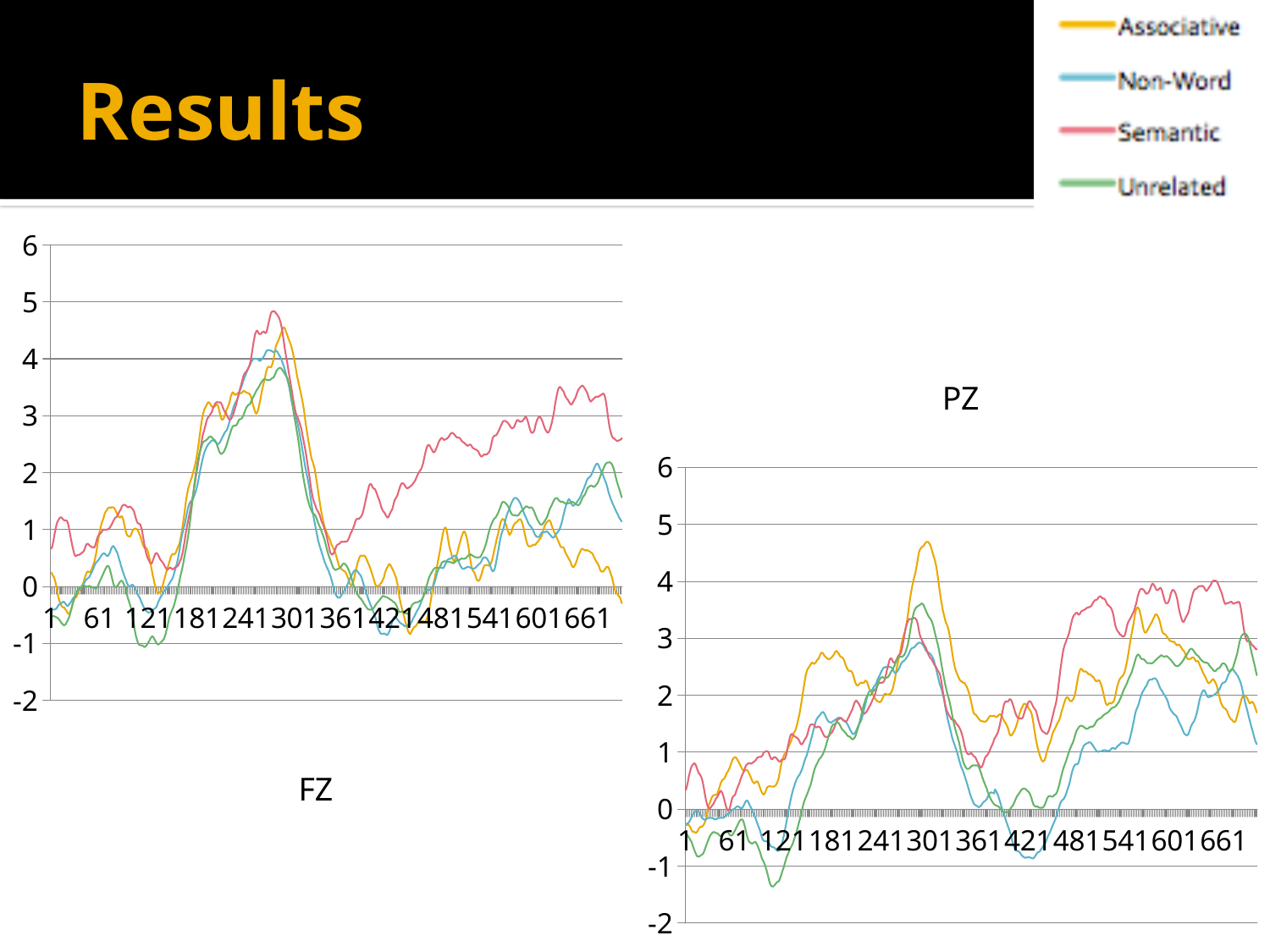
In the FZ chart, is the peak value of the Semantic series greater or less than 4? greater In the PZ chart, which series reaches the highest peak? Associative Which series is drawn in red in the legend? Semantic In the PZ chart, is the lowest value of the Unrelated series greater or less than -1? less What kind of chart is the FZ chart? line chart In the FZ chart, is the Semantic series at x = 661 greater or less than 2? greater How many tick labels are shown on the x axis of the PZ chart? 12 How many series does the legend list? 4 What kind of chart is the PZ chart? line chart What are the titles of the two charts on the slide? FZ and PZ In the FZ chart, which series has the highest values between x = 481 and x = 661? Semantic